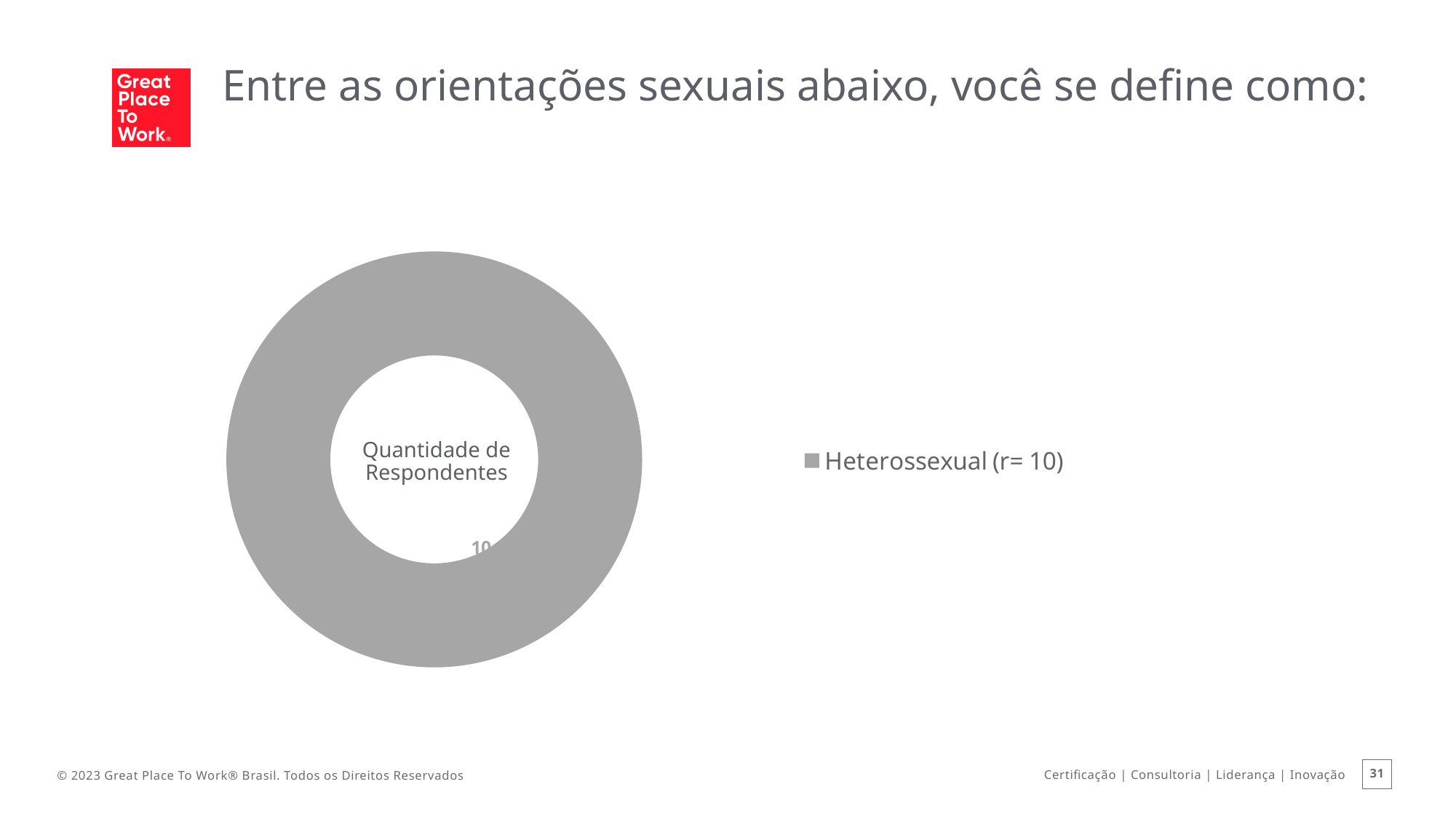
What value is shown for Heterossexual in the chart? 10 What share of the chart does the Heterossexual slice represent? 100% Is the value for Heterossexual greater or less than 5? greater What is the legend entry shown next to the chart? Heterossexual (r= 10) What is the total number of respondents shown in the chart? 10 How many categories does the chart show? 1 What text appears in the centre of the doughnut chart? Quantidade de Respondentes How many entries does the chart legend list? 1 Which category has the highest value in the chart? Heterossexual What kind of chart is shown on the slide? Doughnut (pie) chart